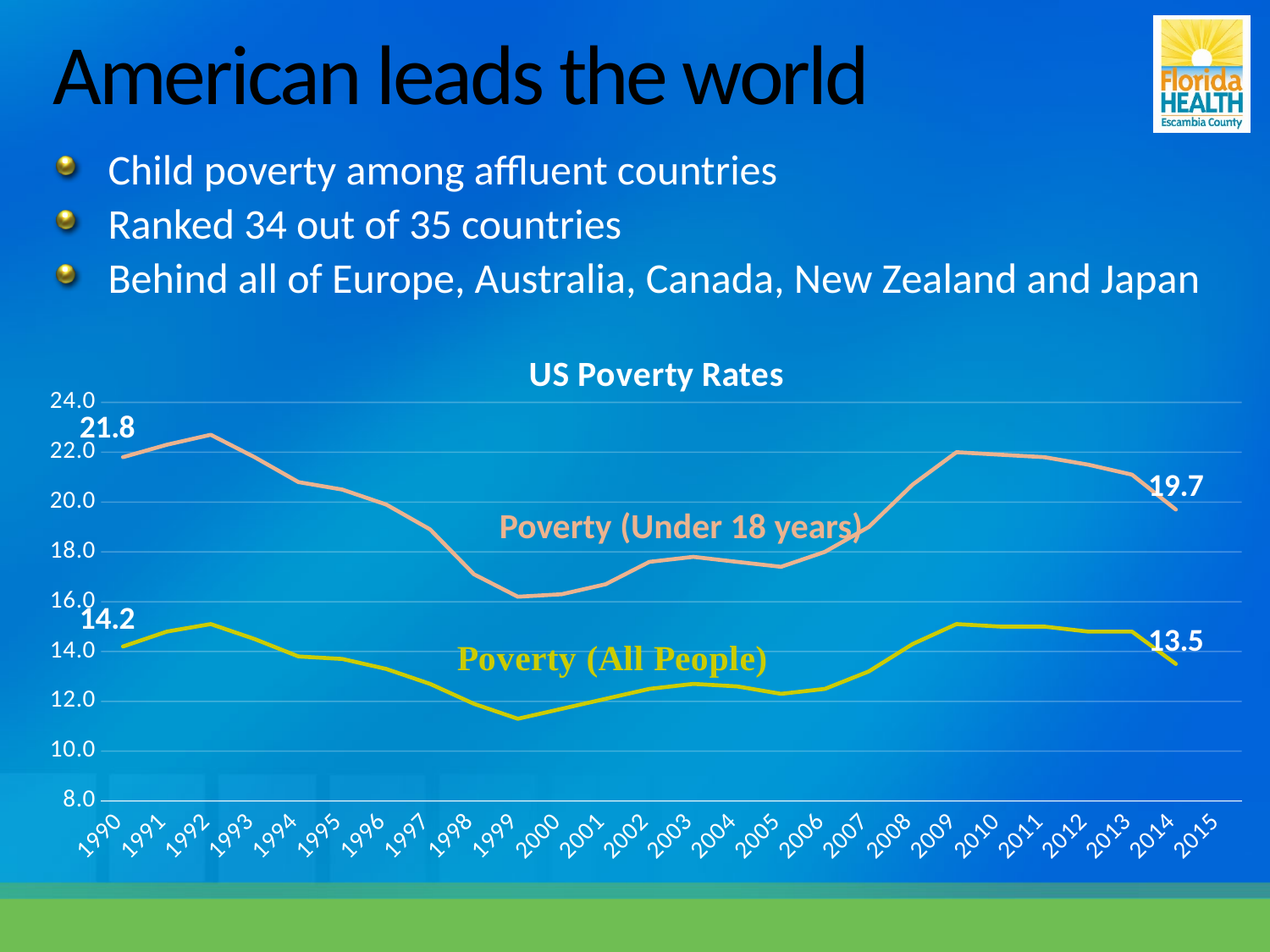
What is the Poverty (Under 18 years) value in 1990? 21.8 By how much did the Poverty (Under 18 years) value fall from 1990 to 2014? 2.1 Which series has the higher value in 2014, Poverty (Under 18 years) or Poverty (All People)? Poverty (Under 18 years) How many series are plotted in the US Poverty Rates chart? 2 What is the Poverty (All People) value in 1990? 14.2 Is the Poverty (Under 18 years) value for 2009 greater or less than 20.0? greater What is the Poverty (Under 18 years) value in 2014? 19.7 What is the title of the chart on the slide? US Poverty Rates What kind of chart is the US Poverty Rates chart? line chart What is the difference between the Poverty (Under 18 years) and Poverty (All People) values in 1990? 7.6 What is the Poverty (All People) value in 2014? 13.5 Is the Poverty (All People) value for 1999 greater or less than 12.0? less